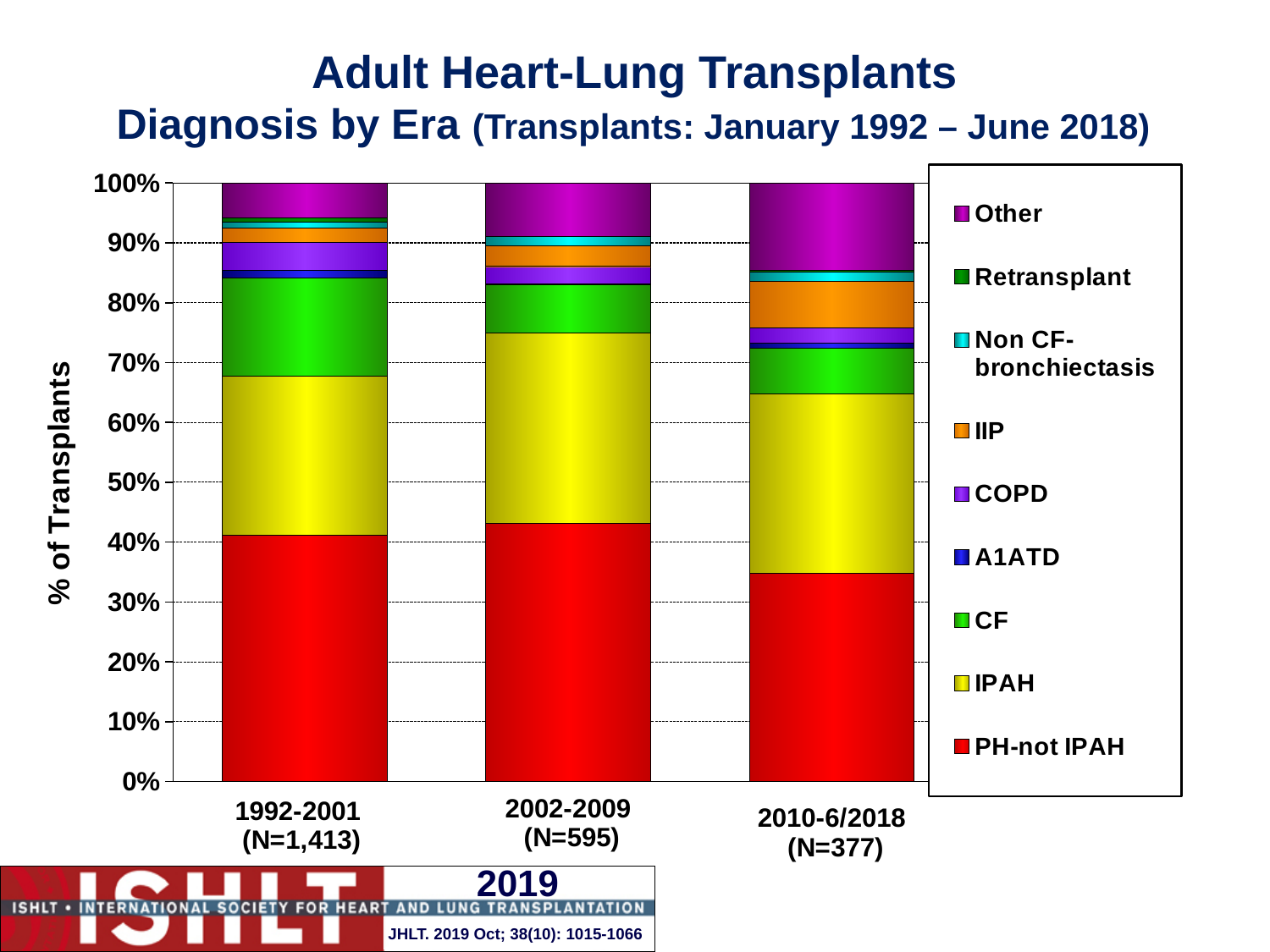
Which era has the largest Other segment? 2010-6/2018 Which era has the largest CF segment? 1992-2001 How many era categories are shown on the x axis? 3 Which era has the largest IIP segment? 2010-6/2018 What kind of chart is shown on the slide? Stacked bar chart Is the PH-not IPAH share for 1992-2001 greater or less than 30%? greater What is the label of the y axis? % of Transplants How many diagnosis series does the legend list? 9 Is the PH-not IPAH share for 2002-2009 greater or less than 50%? less Is the PH-not IPAH share for 2010-6/2018 greater or less than 40%? less What is the number of transplants (N) shown for the 1992-2001 era? N=1,413 Which era has the smaller PH-not IPAH share, 1992-2001 or 2010-6/2018? 2010-6/2018